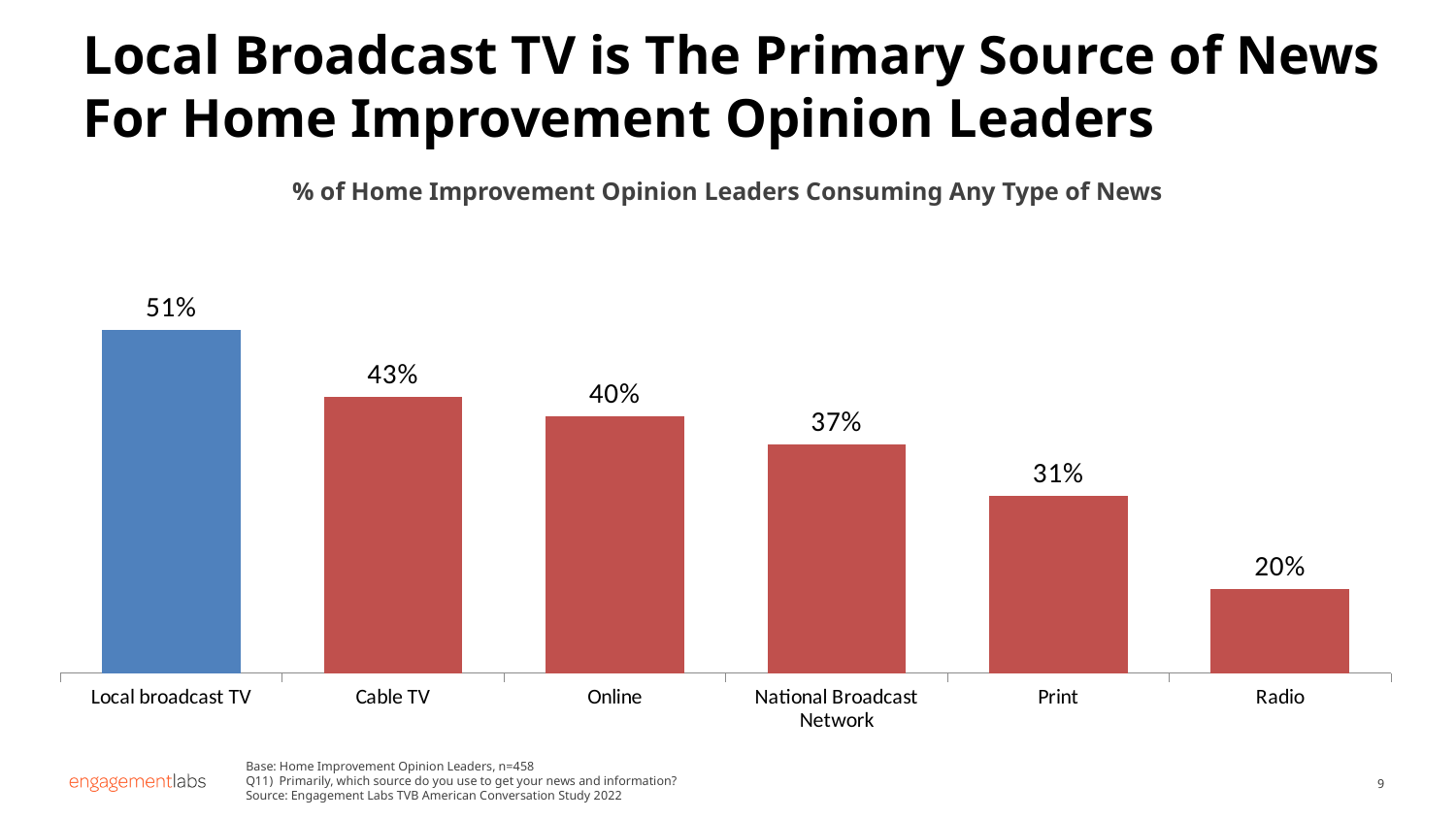
What is the value shown for Radio? 20% Which is larger, the value for Online or the value for Print? Online What is the difference in percentage points between Print and Radio? 11 What is the value shown for Cable TV? 43% Which news source has the lowest percentage? Radio What is the difference in percentage points between Local broadcast TV and Cable TV? 8 What type of chart is shown on the slide? Bar chart Which news source has the highest percentage? Local broadcast TV Which bar is coloured differently (blue) from the others? Local broadcast TV How many news source categories are shown in the chart? 6 What is the value shown for National Broadcast Network? 37% What percentage of Home Improvement Opinion Leaders consume news via Local broadcast TV? 51%